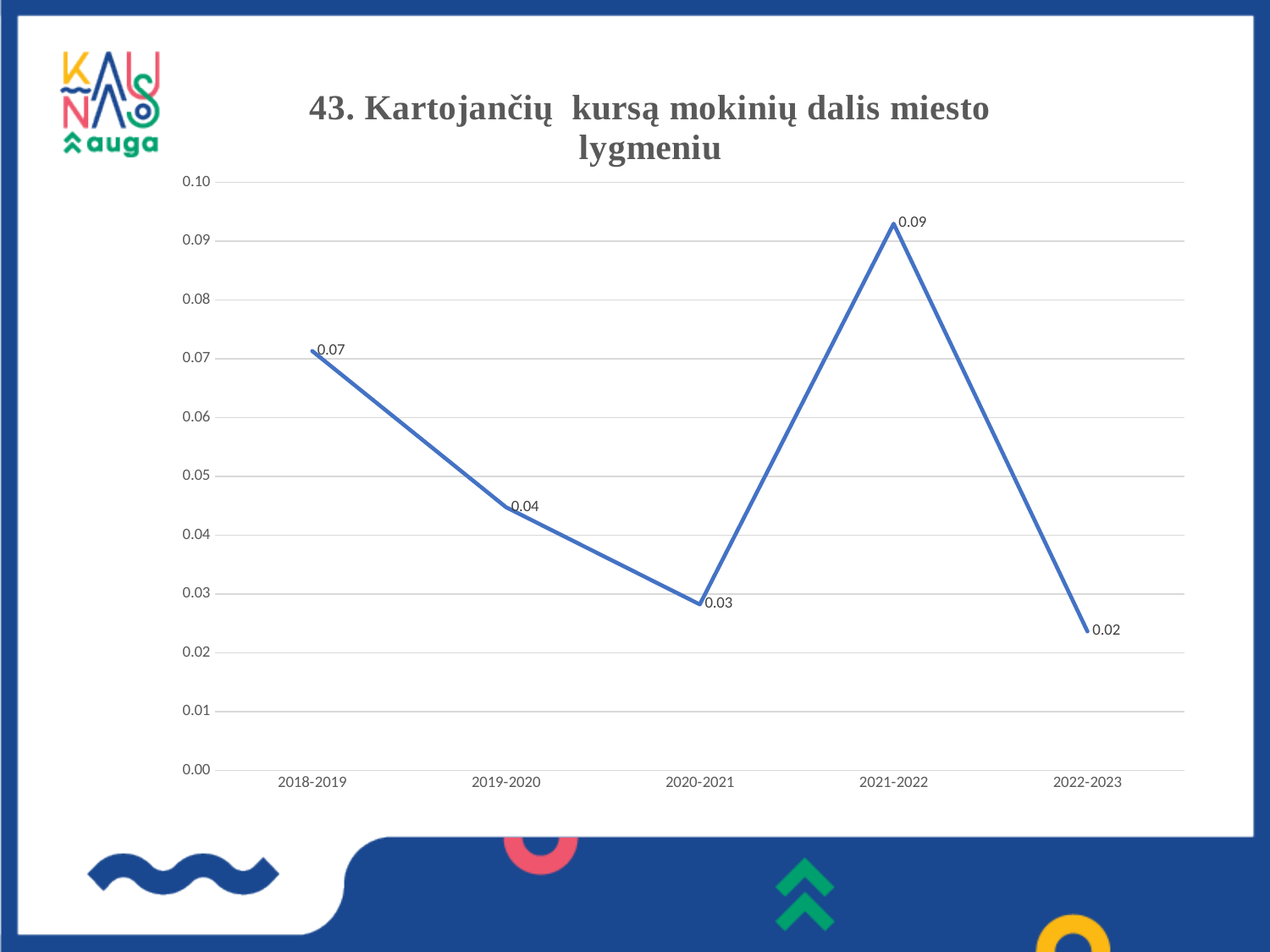
Which school year has the lowest value? 2022-2023 What is the value for 2020-2021? 0.03 What is the value for 2018-2019? 0.07 Which school year has the highest value? 2021-2022 What is the value for 2019-2020? 0.04 Which is larger, the value for 2018-2019 or the value for 2019-2020? 2018-2019 How many school years are plotted on the x axis? 5 What kind of chart is shown on the slide? line chart Do the values rise or fall from 2018-2019 to 2020-2021? fall What is the value for 2022-2023? 0.02 What is the value for 2021-2022? 0.09 What is the difference between the values for 2021-2022 and 2022-2023? 0.07